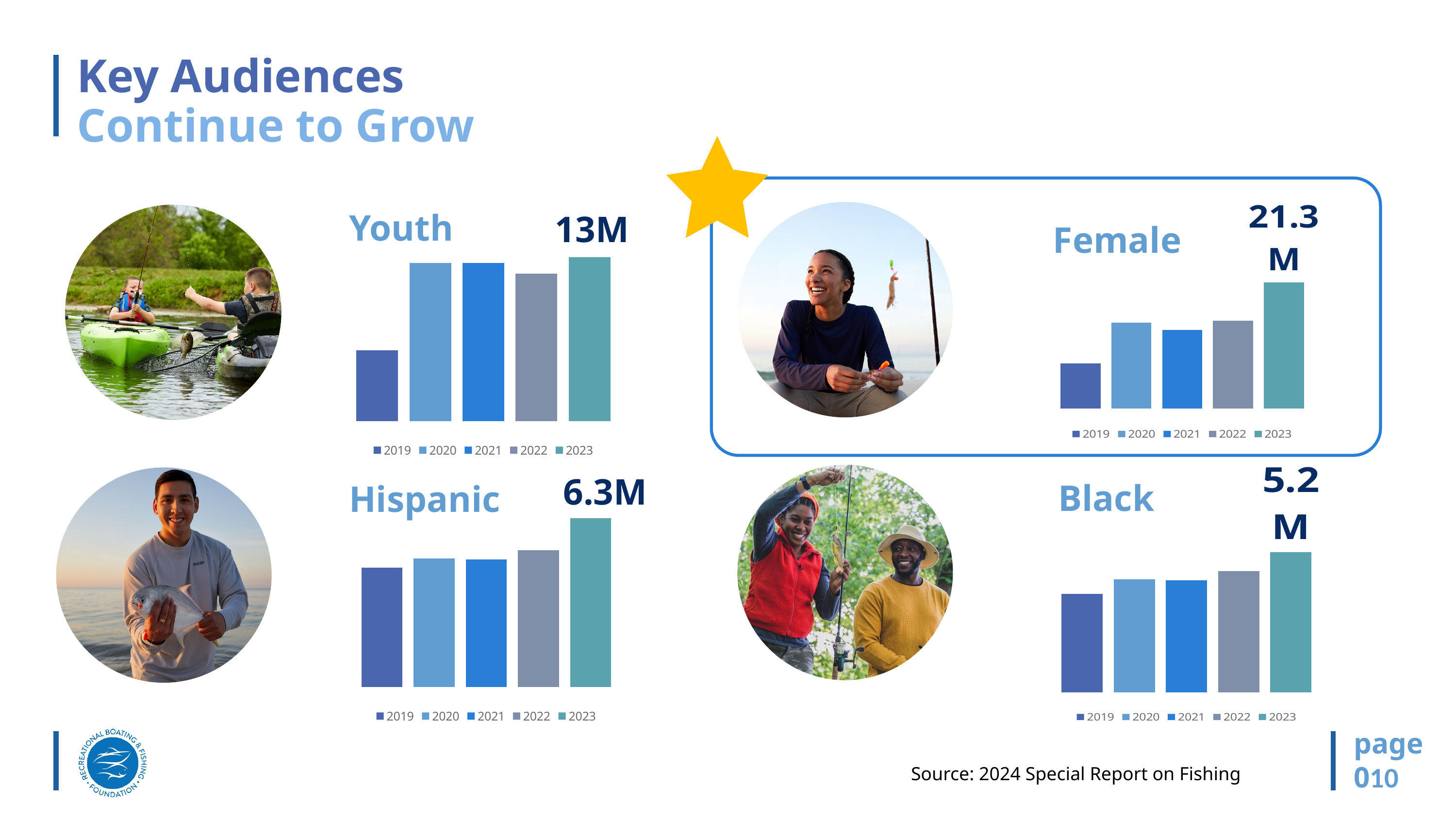
In the Female chart, what value is printed for 2023? 21.3M In the Female chart, which year has the highest bar? 2023 How many entries does the legend of the Black chart list? 5 In the Youth chart, which year has the lowest bar? 2019 How many bars are shown in the Female chart? 5 In the Youth chart, what value is printed for 2023? 13M In the Black chart, which year has the lowest bar? 2019 In the Youth chart, which is larger, the bar for 2019 or the bar for 2020? 2020 In the Hispanic chart, what value is printed for 2023? 6.3M In the Black chart, what value is printed for 2023? 5.2M What type of chart is the Hispanic chart? Bar chart In the Hispanic chart, which year has the highest bar? 2023